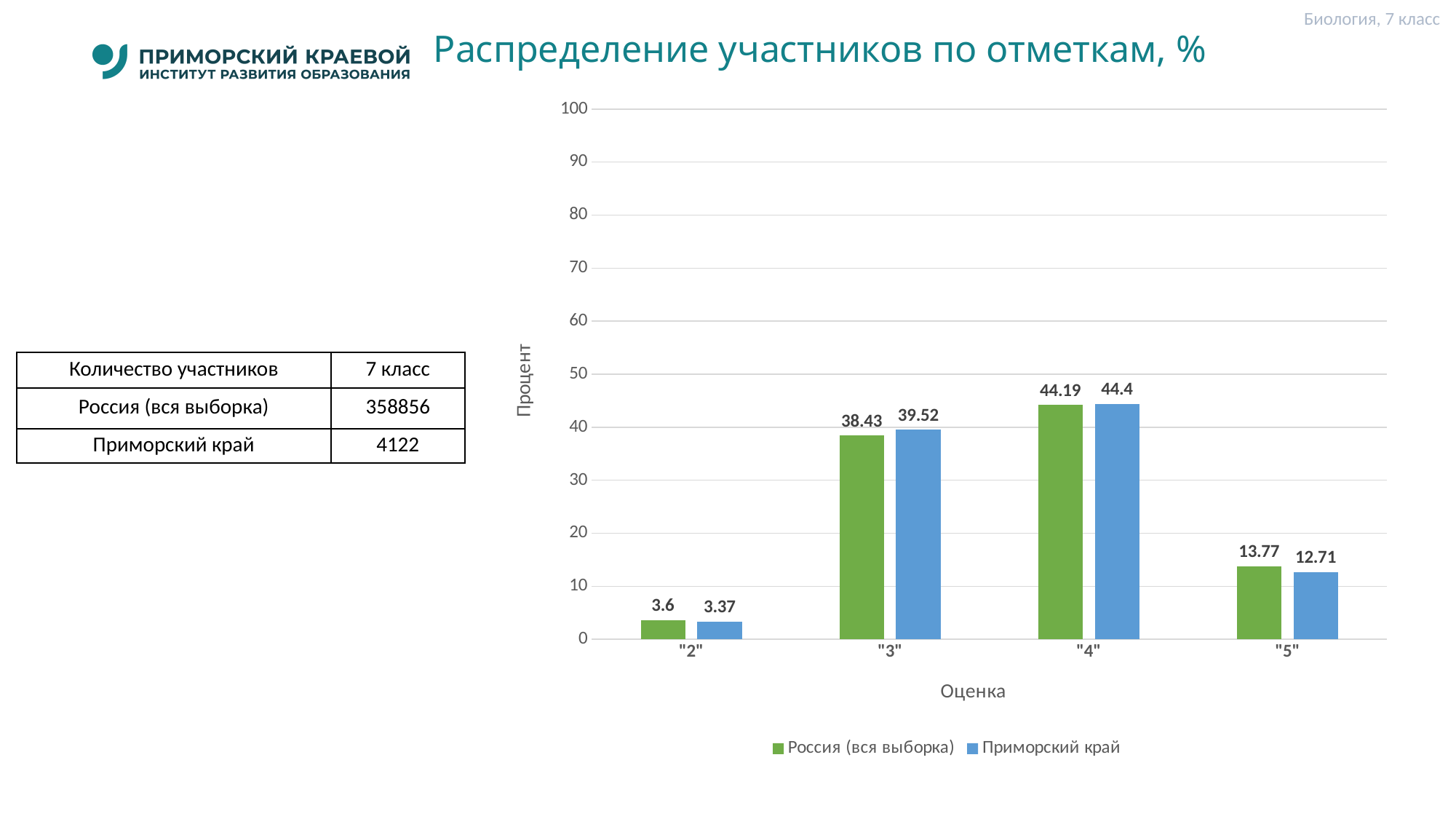
Is the value for Россия (вся выборка) at grade "4" greater or less than 40? greater How many grade categories are shown on the x axis? 4 What kind of chart is shown on the slide? bar chart At grade "5", which series has the larger value: Россия (вся выборка) or Приморский край? Россия (вся выборка) What is the label of the y axis? Процент What is the value for Приморский край at grade "2"? 3.37 What is the value for Россия (вся выборка) at grade "3"? 38.43 How many series does the legend list? 2 Which grade has the lowest value for Россия (вся выборка)? "2" What is the difference between the Приморский край and Россия (вся выборка) values at grade "3"? 1.09 What is the value for Приморский край at grade "5"? 12.71 Which grade has the highest value for Приморский край? "4"